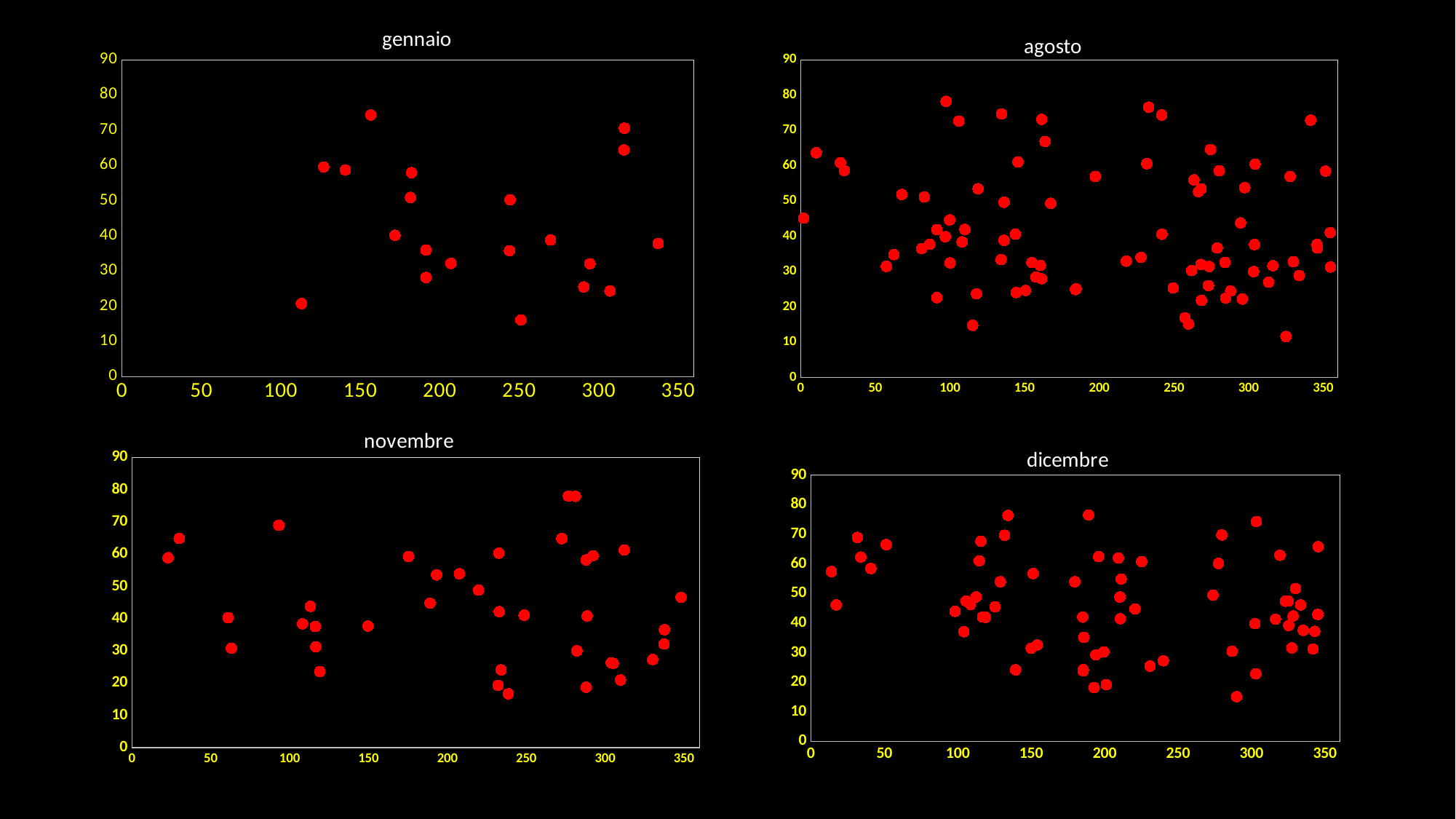
What are the titles of the four charts on the slide? gennaio, agosto, novembre, dicembre In the novembre chart, is the y value of the lowest point greater or less than 20? less In the gennaio chart, is the y value of the lowest point greater or less than 20? less In the novembre chart, is the y value of the highest point greater or less than 70? greater What colour are the data points in the agosto chart? red What kind of chart is the chart titled gennaio? scatter chart How many charts are shown on the slide? 4